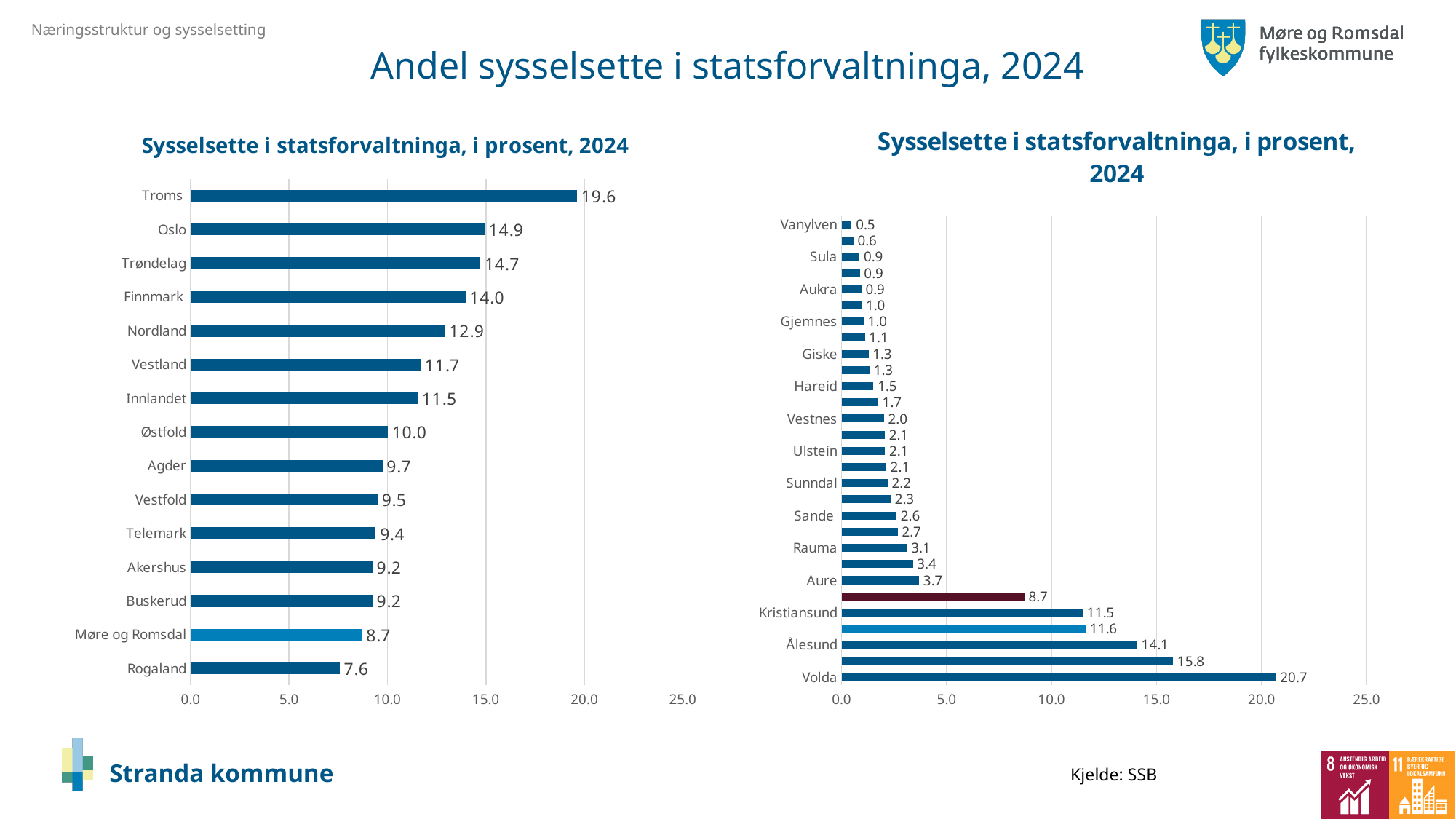
In the left chart, what is the value for Troms? 19.6 In the left chart, which is larger, the value for Nordland or the value for Vestland? Nordland In the left chart, which category has the highest value? Troms In the left chart, which bar is drawn in a lighter blue than the others? Møre og Romsdal In the right chart, what is the difference between the values for Volda and Ålesund? 6.6 In the left chart, what is the value for Møre og Romsdal? 8.7 In the left chart, what is the difference between the values for Oslo and Trøndelag? 0.2 How many categories are shown in the left chart? 15 What kind of chart is the left chart? Bar chart In the left chart, which category has the lowest value? Rogaland In the right chart, which labelled category has the lowest value? Vanylven In the right chart, what is the value for Volda? 20.7